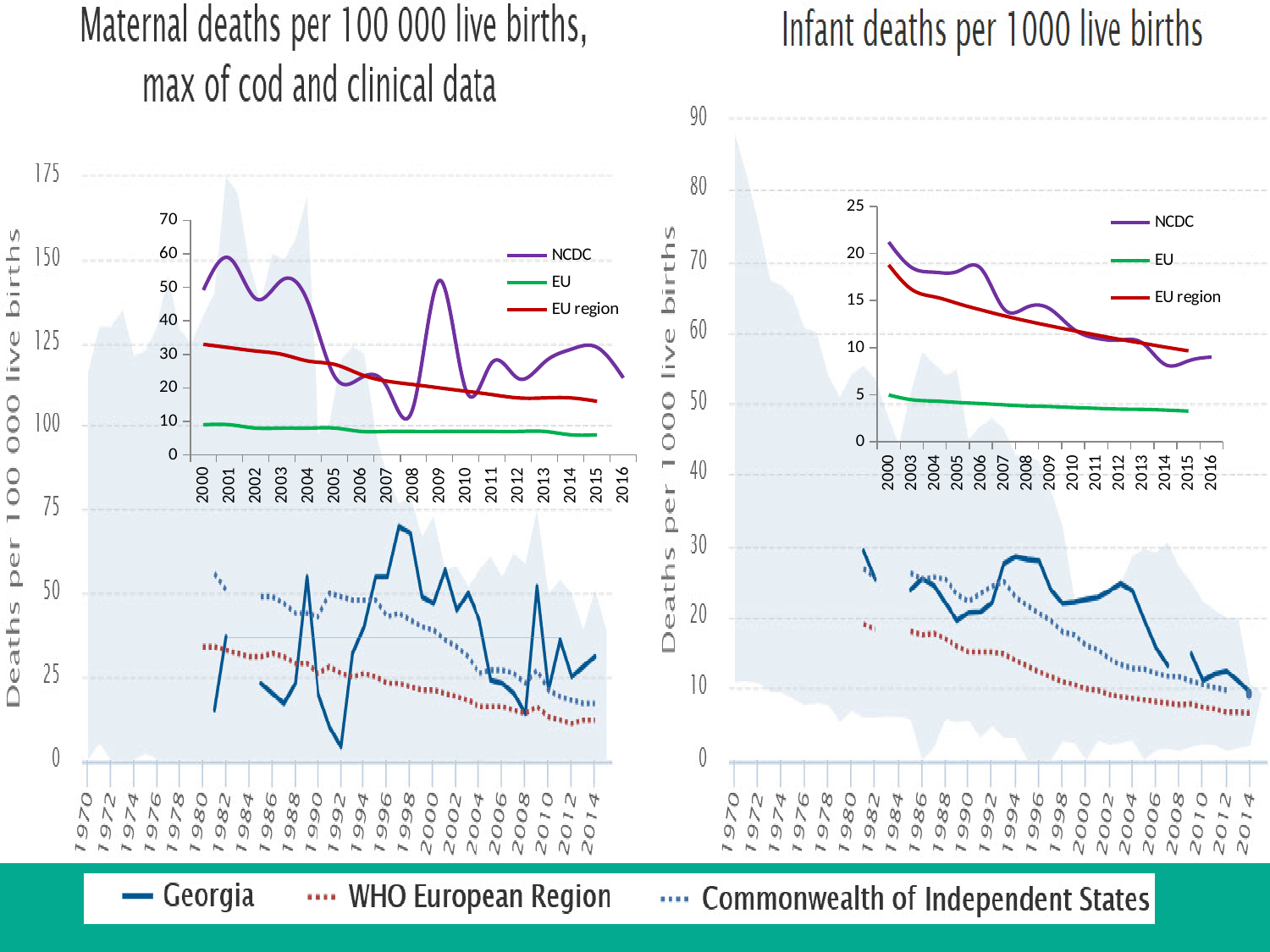
In the inset chart of the 'Infant deaths per 1000 live births' panel, which series is lowest across all years? EU In the inset chart of the 'Maternal deaths per 100 000 live births' panel, which is larger in 2015, EU region or EU? EU region How many series does the legend of the inset chart in the 'Maternal deaths per 100 000 live births' panel list? 3 In the inset chart of the 'Infant deaths per 1000 live births' panel, which series is highest in 2000? NCDC In the inset chart of the 'Infant deaths per 1000 live births' panel, is the NCDC value in 2000 greater or less than 15? greater In the inset chart of the 'Maternal deaths per 100 000 live births' panel, is the EU value in 2000 greater or less than 20? less In the inset chart of the 'Maternal deaths per 100 000 live births' panel, which is larger in 2000, NCDC or EU region? NCDC In the inset chart of the 'Infant deaths per 1000 live births' panel, does the EU region line rise or fall from 2000 to 2015? fall What kind of chart is the inset chart on the 'Infant deaths per 1000 live births' slide panel? line chart In the main chart of the 'Infant deaths per 1000 live births' panel, is the Georgia value in 1994 greater or less than 20? greater How many series does the legend at the bottom of the slide list? 3 What colour is the NCDC line in the inset charts? purple